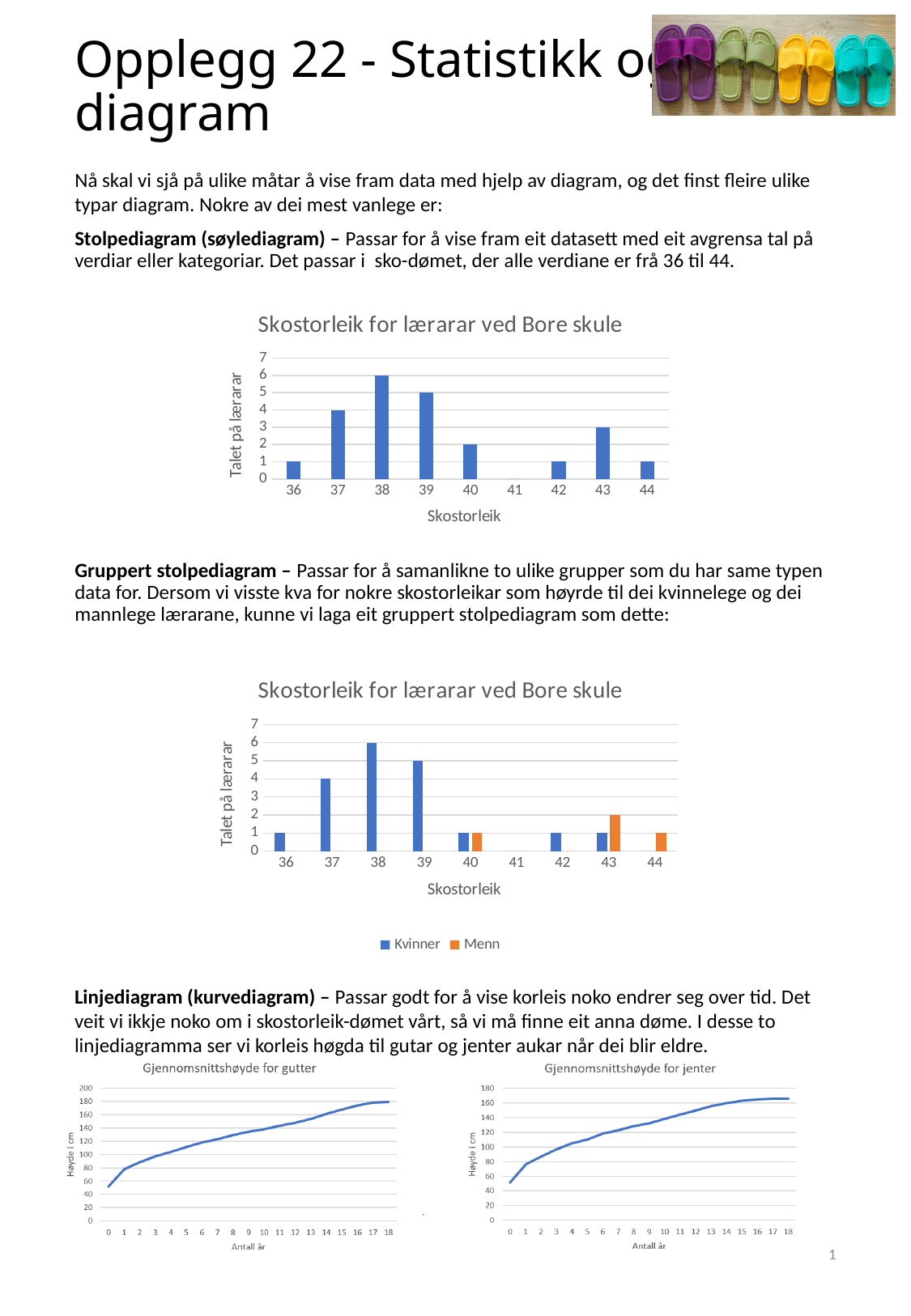
In the top bar chart 'Skostorleik for lærarar ved Bore skule', which shoe size has no teachers at all? 41 In the top bar chart 'Skostorleik for lærarar ved Bore skule', what is the difference between the number of teachers with size 39 and size 40? 3 In the chart 'Gjennomsnittshøyde for jenter', is the height at 18 years greater or less than 180? less In the top bar chart 'Skostorleik for lærarar ved Bore skule', which shoe size has the highest number of teachers? 38 In the grouped bar chart 'Skostorleik for lærarar ved Bore skule', what colour are the Menn bars? Orange In the top bar chart 'Skostorleik for lærarar ved Bore skule', how many teachers have shoe size 43? 3 In the top bar chart 'Skostorleik for lærarar ved Bore skule', how many teachers have shoe size 38? 6 What kind of chart is 'Gjennomsnittshøyde for gutter'? Line chart In the grouped bar chart 'Skostorleik for lærarar ved Bore skule', how many series does the legend list? 2 In the grouped bar chart 'Skostorleik for lærarar ved Bore skule', how many men (Menn) have shoe size 43? 2 In the grouped bar chart 'Skostorleik for lærarar ved Bore skule', which series is larger at shoe size 43, Kvinner or Menn? Menn In the top bar chart 'Skostorleik for lærarar ved Bore skule', how many shoe size categories are shown on the x axis? 9